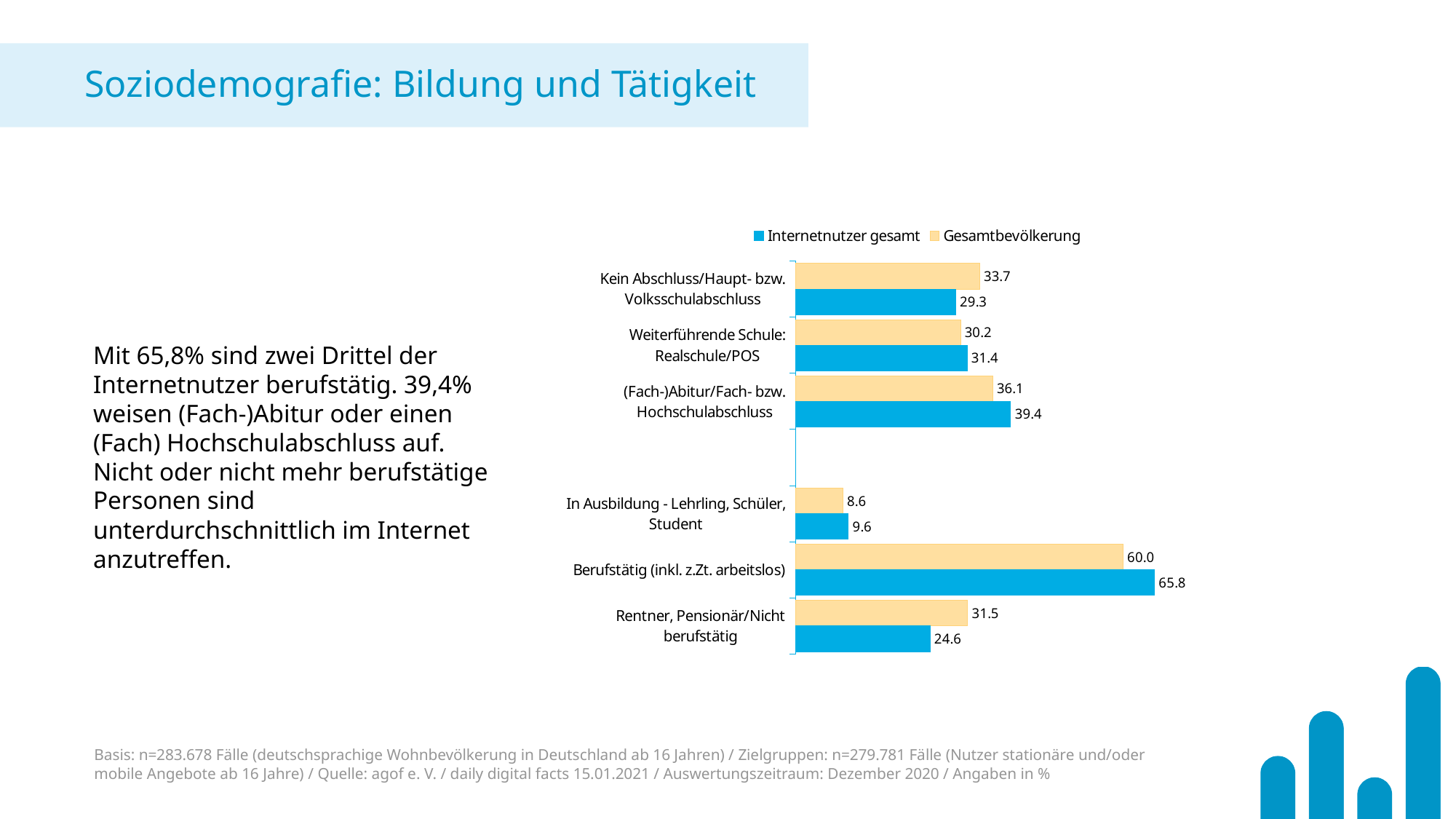
How many series does the legend list? 2 What is the difference between Internetnutzer gesamt and Gesamtbevölkerung in the category Berufstätig (inkl. z.Zt. arbeitslos)? 5.8 Which colour represents the series Gesamtbevölkerung in the chart? Yellow How many categories are shown on the chart? 6 Which category has the highest value for Internetnutzer gesamt? Berufstätig (inkl. z.Zt. arbeitslos) What is the value for Gesamtbevölkerung in the category Kein Abschluss/Haupt- bzw. Volksschulabschluss? 33.7 Which category has the lowest value for Gesamtbevölkerung? In Ausbildung - Lehrling, Schüler, Student What is the value for Internetnutzer gesamt in the category Berufstätig (inkl. z.Zt. arbeitslos)? 65.8 What kind of chart is shown on the slide? Bar chart In the category (Fach-)Abitur/Fach- bzw. Hochschulabschluss, which series has the larger value: Internetnutzer gesamt or Gesamtbevölkerung? Internetnutzer gesamt What is the value for Internetnutzer gesamt in the category Rentner, Pensionär/Nicht berufstätig? 24.6 In the category Rentner, Pensionär/Nicht berufstätig, which series has the larger value: Internetnutzer gesamt or Gesamtbevölkerung? Gesamtbevölkerung